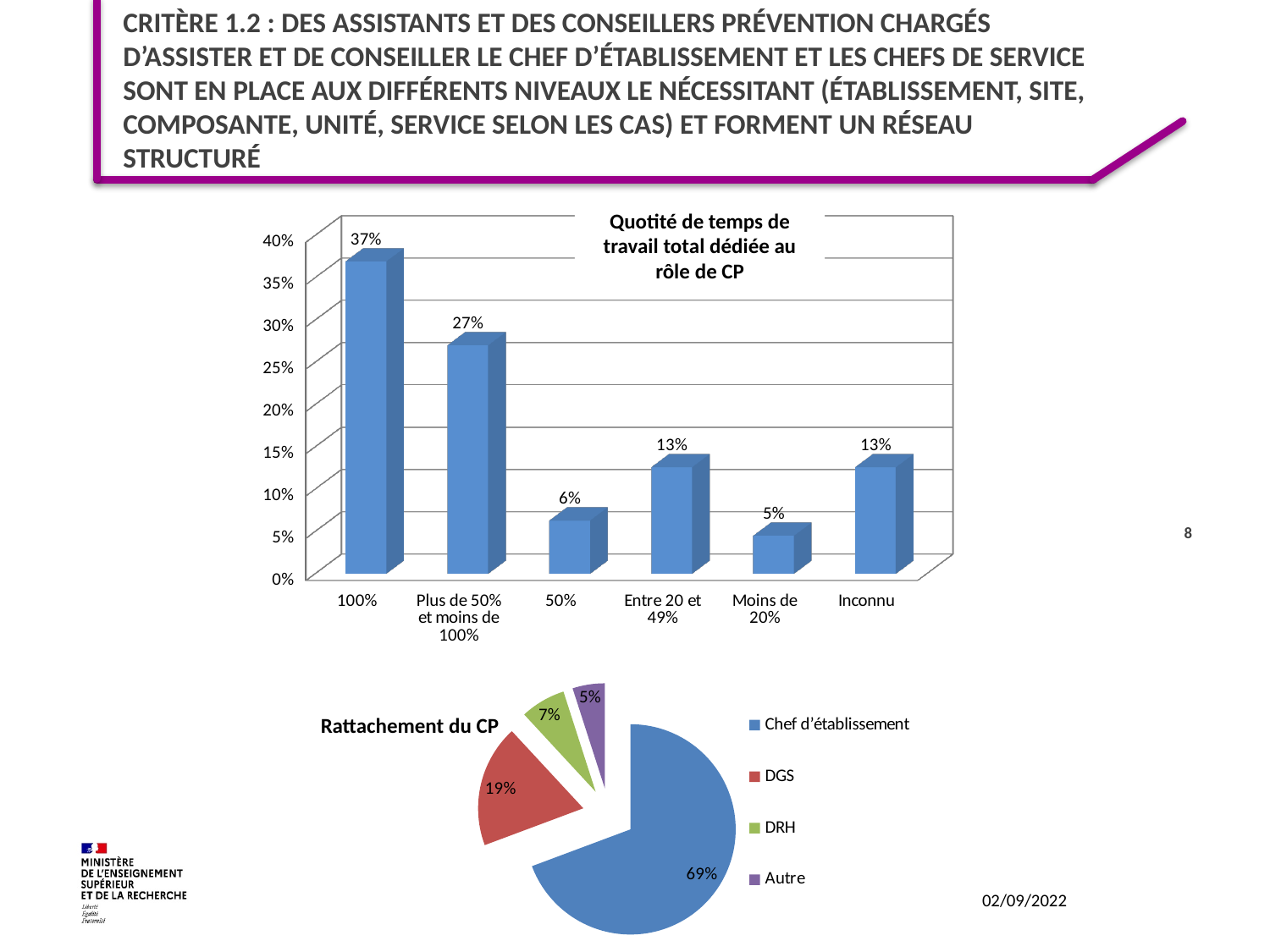
In the bar chart 'Quotité de temps de travail total dédiée au rôle de CP', what is the value for the '100%' category? 37% In the bar chart 'Quotité de temps de travail total dédiée au rôle de CP', which category has the highest value? 100% In the bar chart 'Quotité de temps de travail total dédiée au rôle de CP', what is the difference between the '100%' and 'Plus de 50% et moins de 100%' values? 10% In the bar chart 'Quotité de temps de travail total dédiée au rôle de CP', which is larger: the value for '50%' or the value for 'Entre 20 et 49%'? Entre 20 et 49% How many categories are shown in the bar chart 'Quotité de temps de travail total dédiée au rôle de CP'? 6 In the pie chart 'Rattachement du CP', which category has the smallest slice? Autre In the bar chart 'Quotité de temps de travail total dédiée au rôle de CP', which category has the lowest value? Moins de 20% How many entries does the legend of the pie chart 'Rattachement du CP' list? 4 What kind of chart is the top chart on the slide? Bar chart In the pie chart 'Rattachement du CP', what share does 'Chef d'établissement' have? 69% In the bar chart 'Quotité de temps de travail total dédiée au rôle de CP', what is the value for 'Plus de 50% et moins de 100%'? 27% In the pie chart 'Rattachement du CP', what is the value for 'DGS'? 19%